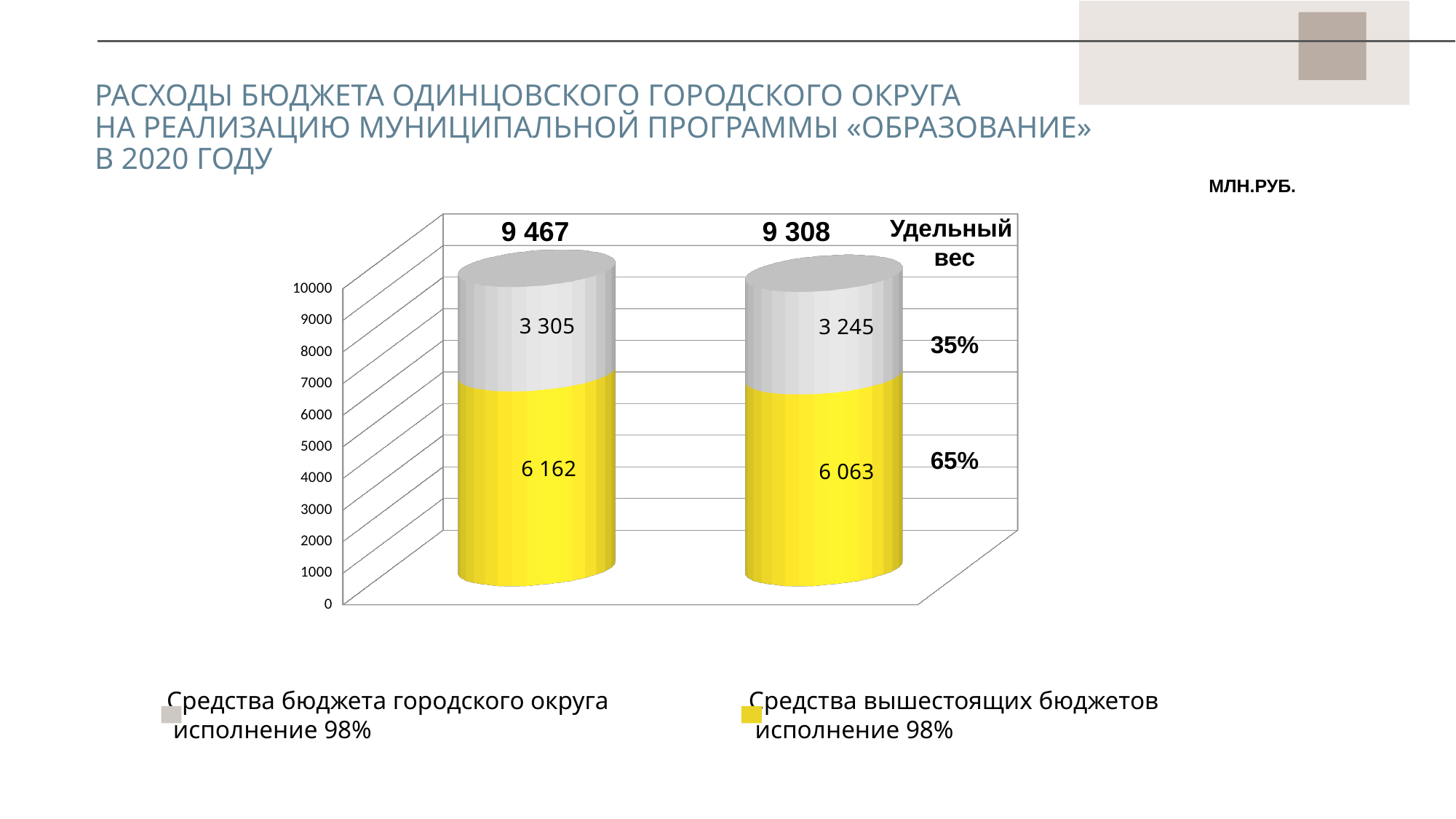
How many bars are plotted in the chart? 2 What is the total printed above the right bar? 9 308 What is the value of the grey segment (Средства бюджета городского округа) in the right bar? 3 245 How many series does the legend list? 2 What unit of measurement is indicated for the chart values? МЛН.РУБ. What share (Удельный вес) is shown for the yellow series, Средства вышестоящих бюджетов? 65% What is the difference between the totals of the left bar (9 467) and the right bar (9 308)? 159 Which is larger: the yellow segment of the left bar or the yellow segment of the right bar? the left bar (6 162) What is the difference between the grey segment values of the left bar (3 305) and the right bar (3 245)? 60 What is the value of the yellow segment (Средства вышестоящих бюджетов) in the left bar? 6 162 What is the total printed above the left bar? 9 467 What kind of chart is shown on the slide? bar chart